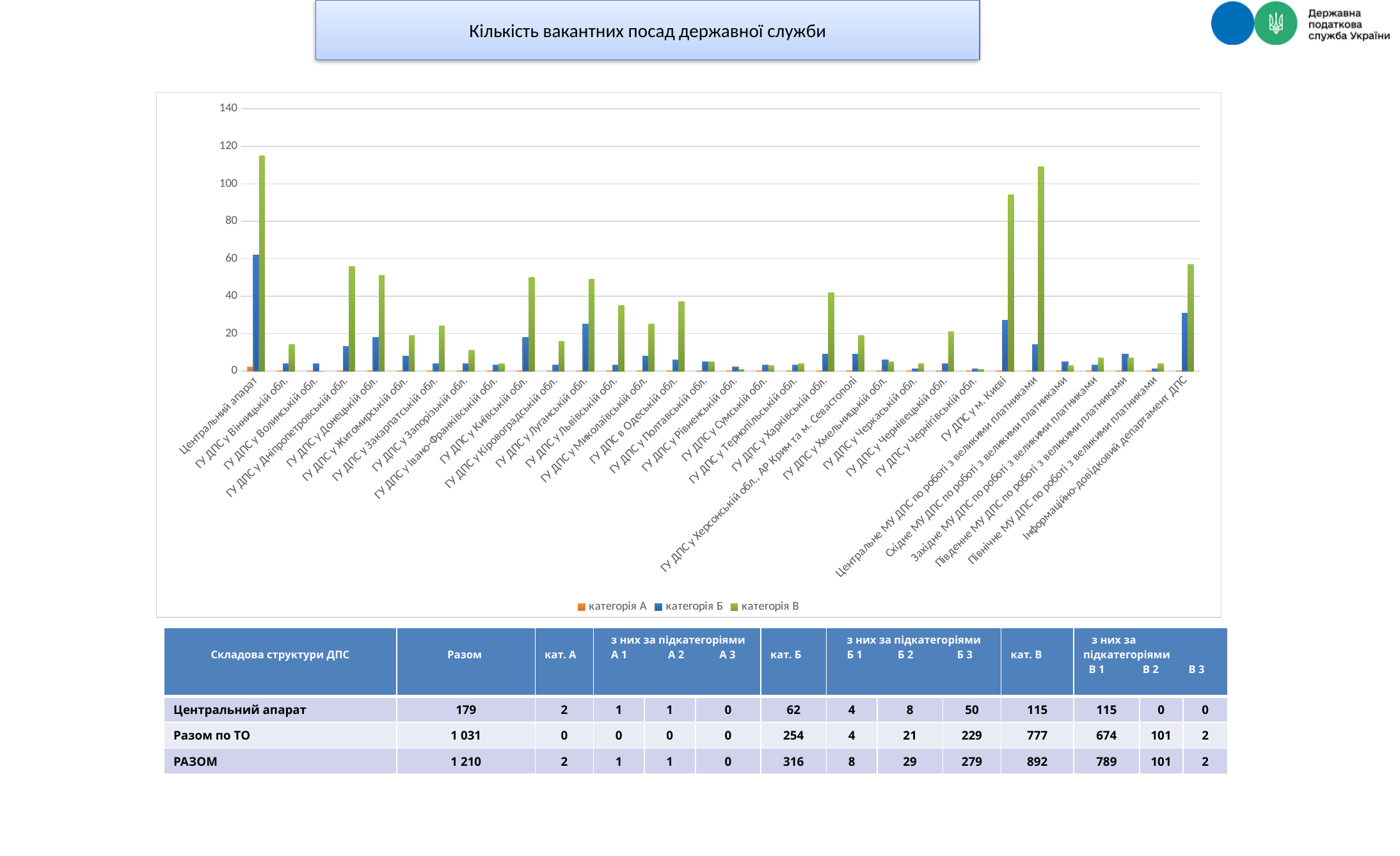
Is the категорія В value for ГУ ДПС у м. Києві greater or less than 80? greater What is the title shown above the chart? Кількість вакантних посад державної служби What is the value of категорія В for Центральний апарат? 115 Is the категорія В value for ГУ ДПС у Донецькій обл. greater or less than 40? greater What are the series names listed in the chart legend? категорія А, категорія Б, категорія В Is the категорія Б value for ГУ ДПС у Львівській обл. greater or less than 20? less What is the value of категорія Б for Центральний апарат? 62 What kind of chart is shown on the slide? bar chart Which has the larger категорія В value: ГУ ДПС у Донецькій обл. or ГУ ДПС у Вінницькій обл.? ГУ ДПС у Донецькій обл. How many series does the chart legend list? 3 Which category has the highest категорія Б bar? Центральний апарат For Центральний апарат, which is larger: категорія Б or категорія В? категорія В